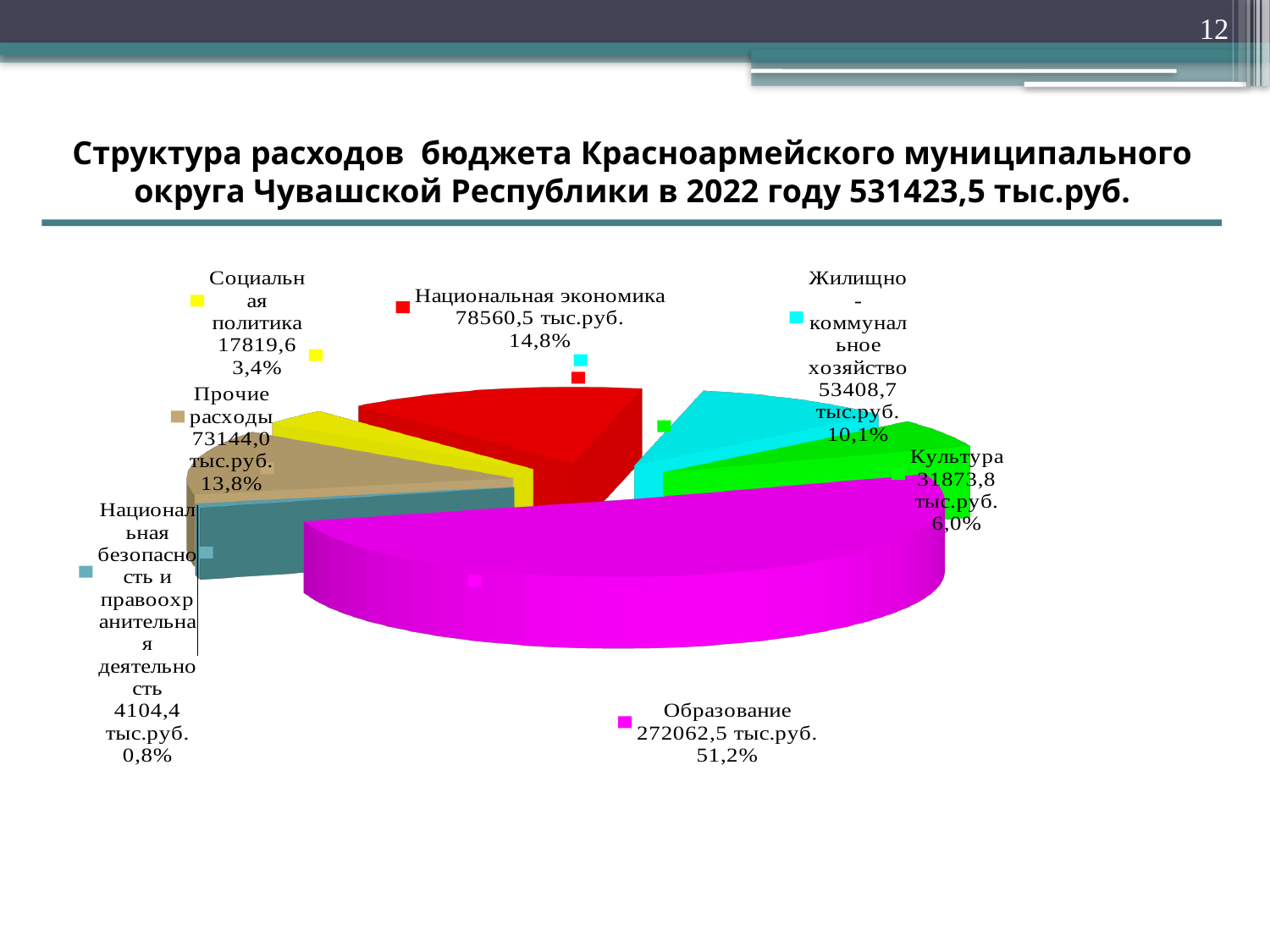
What is the value for Национальная экономика? 78560,5 тыс.руб. What is the value for Образование? 272062,5 тыс.руб. What percentage is shown for Жилищно-коммунальное хозяйство? 10,1% What total amount is stated in the chart title for 2022? 531423,5 тыс.руб. What share of the pie does Образование represent? 51,2% Which is larger, Прочие расходы or Культура? Прочие расходы Which category has the largest share of the pie? Образование What is the difference in percentage points between Национальная экономика and Прочие расходы? 1,0% What kind of chart is shown on the slide? Pie chart What is the value for Социальная политика? 17819,6 тыс.руб.